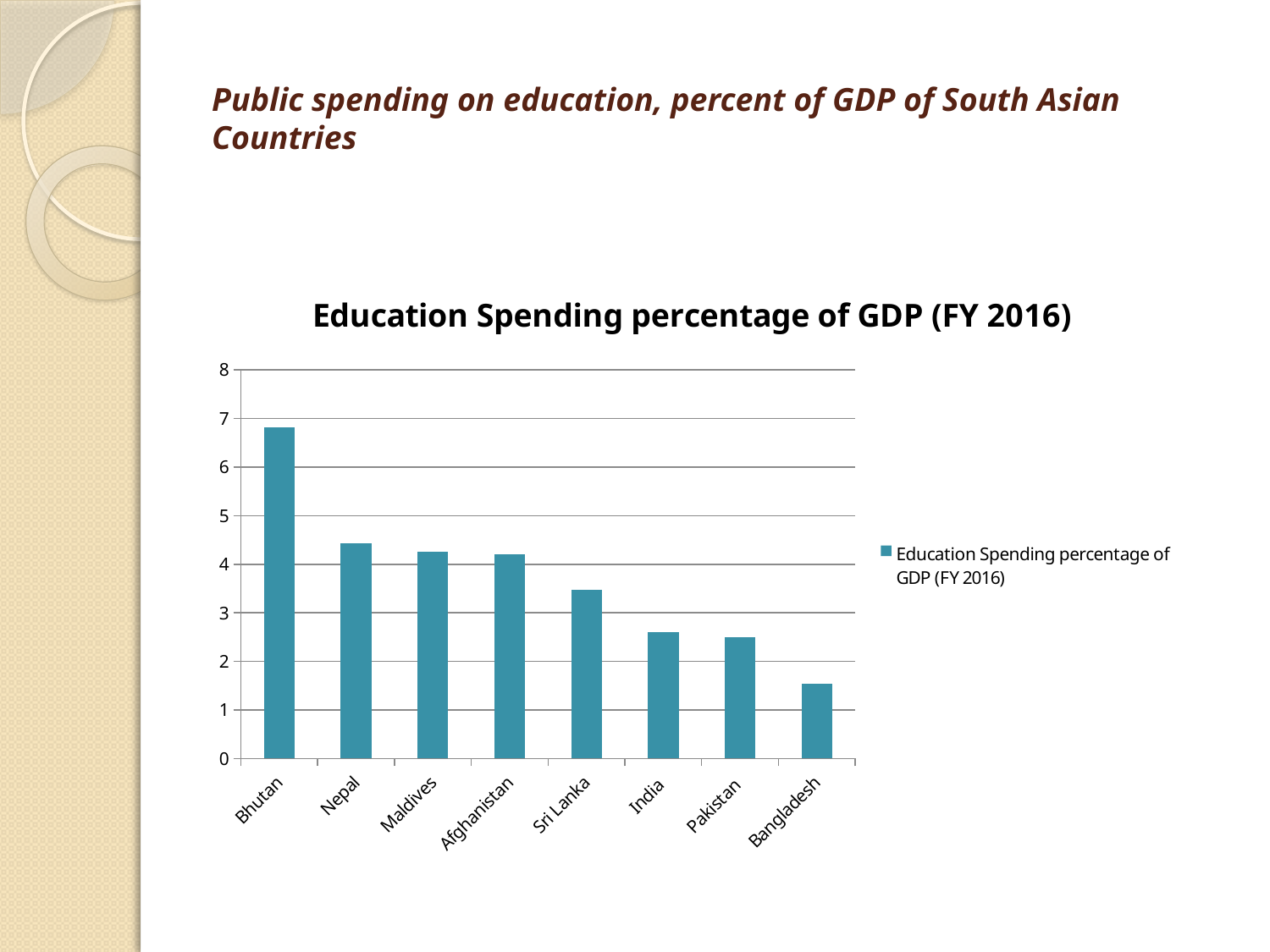
Which has a higher value, Sri Lanka or India? Sri Lanka What is the title of the chart? Education Spending percentage of GDP (FY 2016) Which country has the lowest education spending as a percentage of GDP? Bangladesh How many series does the legend list? 1 Do the values rise or fall moving from left to right along the x axis? fall Which country has the highest education spending as a percentage of GDP? Bhutan How many countries are shown on the x axis of the chart? 8 Is the value for Nepal greater or less than 5? less Is the value for Bangladesh greater or less than 2? less Is the value for Sri Lanka greater or less than 3? greater What kind of chart is shown on the slide? bar chart